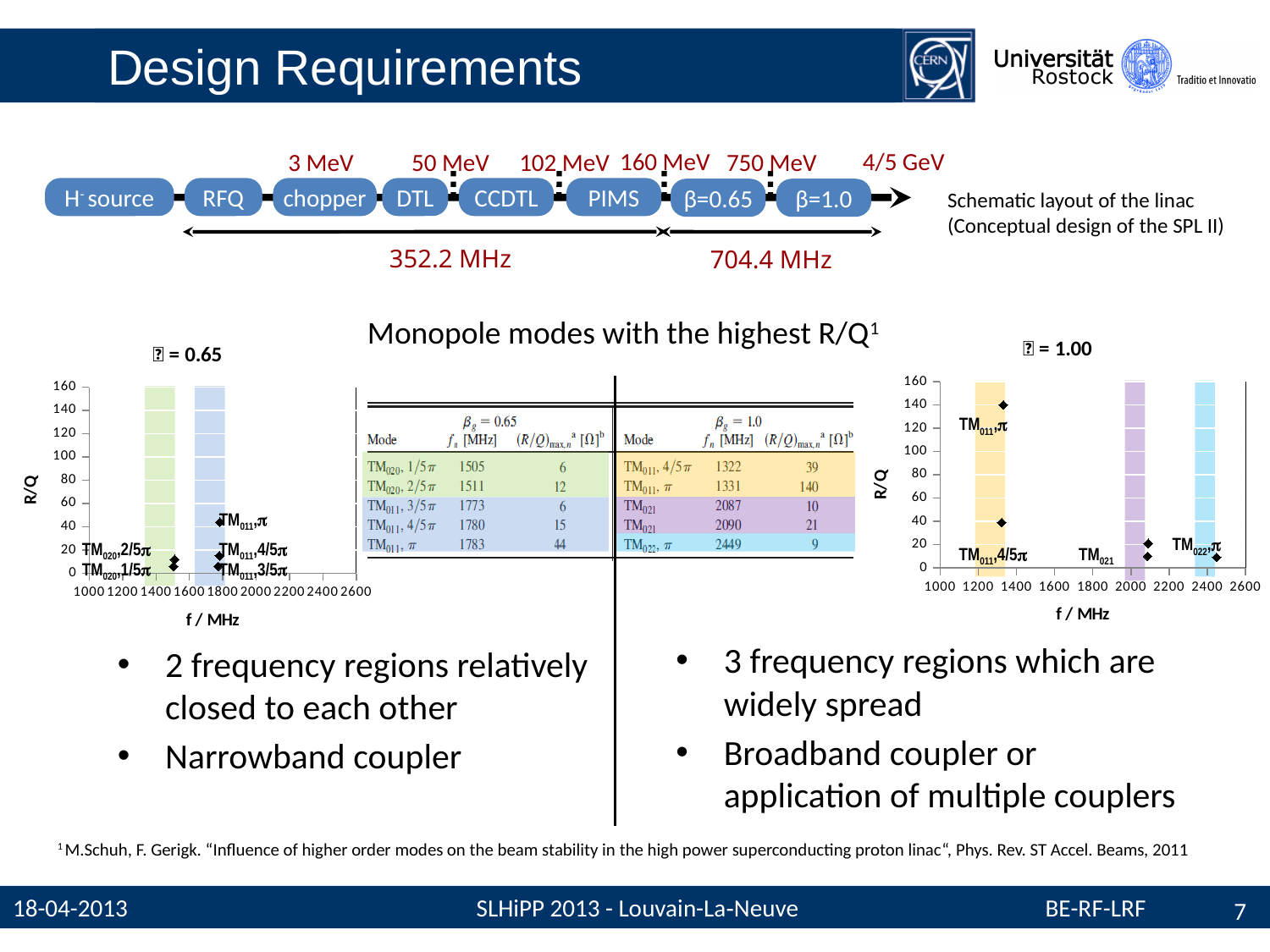
In the "β = 1.00" chart, is the R/Q value for TM011,4/5π greater or less than 20? greater What is the label of the vertical axis in the "β = 0.65" chart? R/Q In the "β = 0.65" chart, is the R/Q value for TM020,2/5π greater or less than 20? less How many shaded frequency regions are highlighted in the "β = 1.00" chart? 3 How many data points are plotted in the "β = 1.00" chart? 5 In the "β = 1.00" chart, which has the larger R/Q: TM011,π or TM022,π? TM011,π In the "β = 1.00" chart, which mode has the highest R/Q? TM011,π In the "β = 1.00" chart, is the R/Q value for TM011,π greater or less than 120? greater In the "β = 0.65" chart, which has the larger R/Q: TM011,π or TM011,4/5π? TM011,π What kind of chart is the "β = 0.65" chart on the left? scatter chart In the "β = 0.65" chart, which mode has the highest R/Q? TM011,π